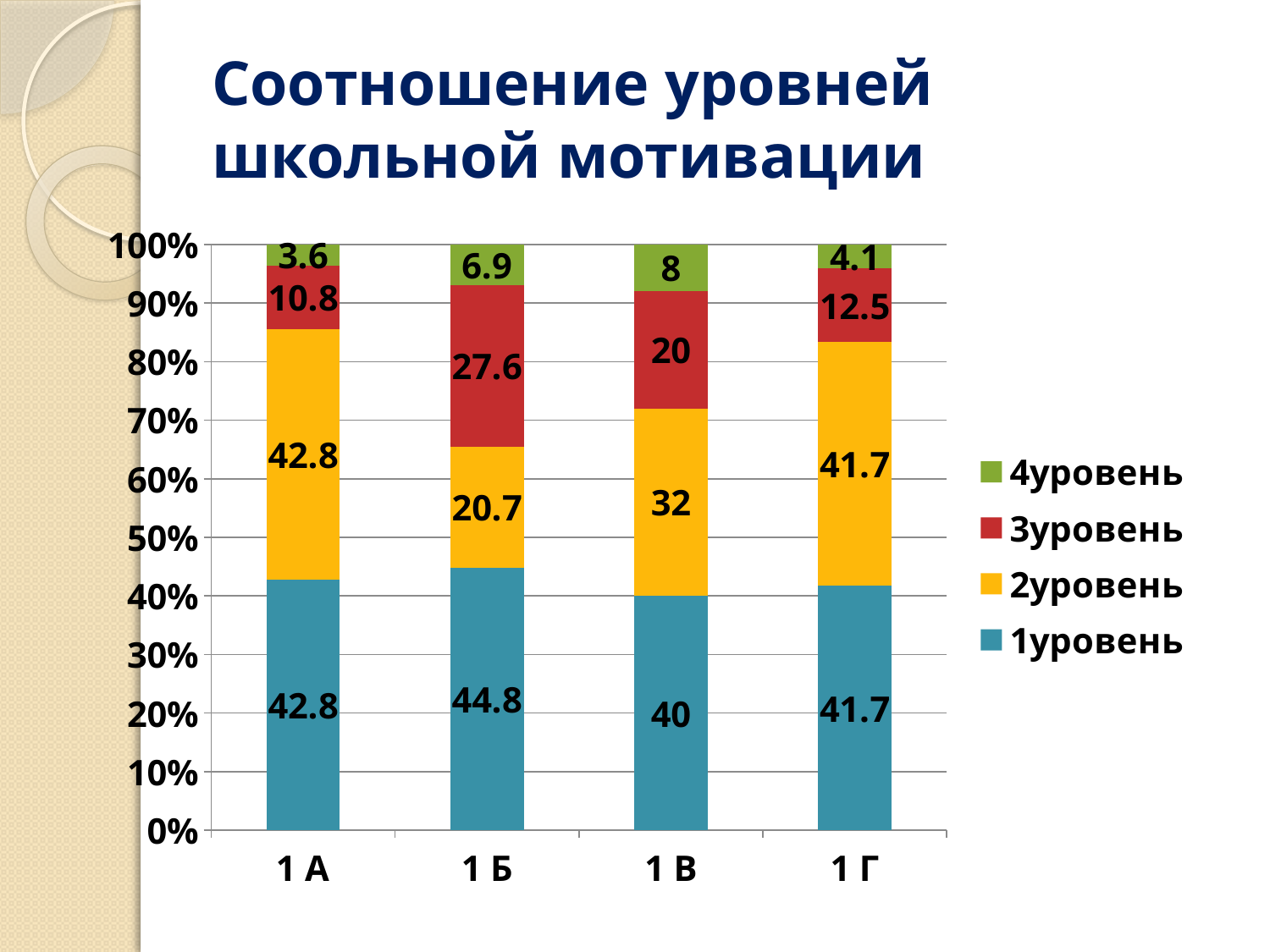
What is the title of the chart? Соотношение уровней школьной мотивации What is the value of 4уровень for 1 Г? 4.1 Which category has the lowest value for 4уровень? 1 А What kind of chart is shown on the slide? stacked bar chart How many categories are shown on the x axis? 4 How many series does the legend list? 4 What is the value of 1уровень for 1 Б? 44.8 What is the value of 2уровень for 1 А? 42.8 Which category has the highest value for 3уровень? 1 Б What is the value of 3уровень for 1 В? 20 Which is larger: the 1уровень value for 1 В or for 1 Г? 1 Г What is the difference between the 2уровень values for 1 А and 1 Б? 22.1